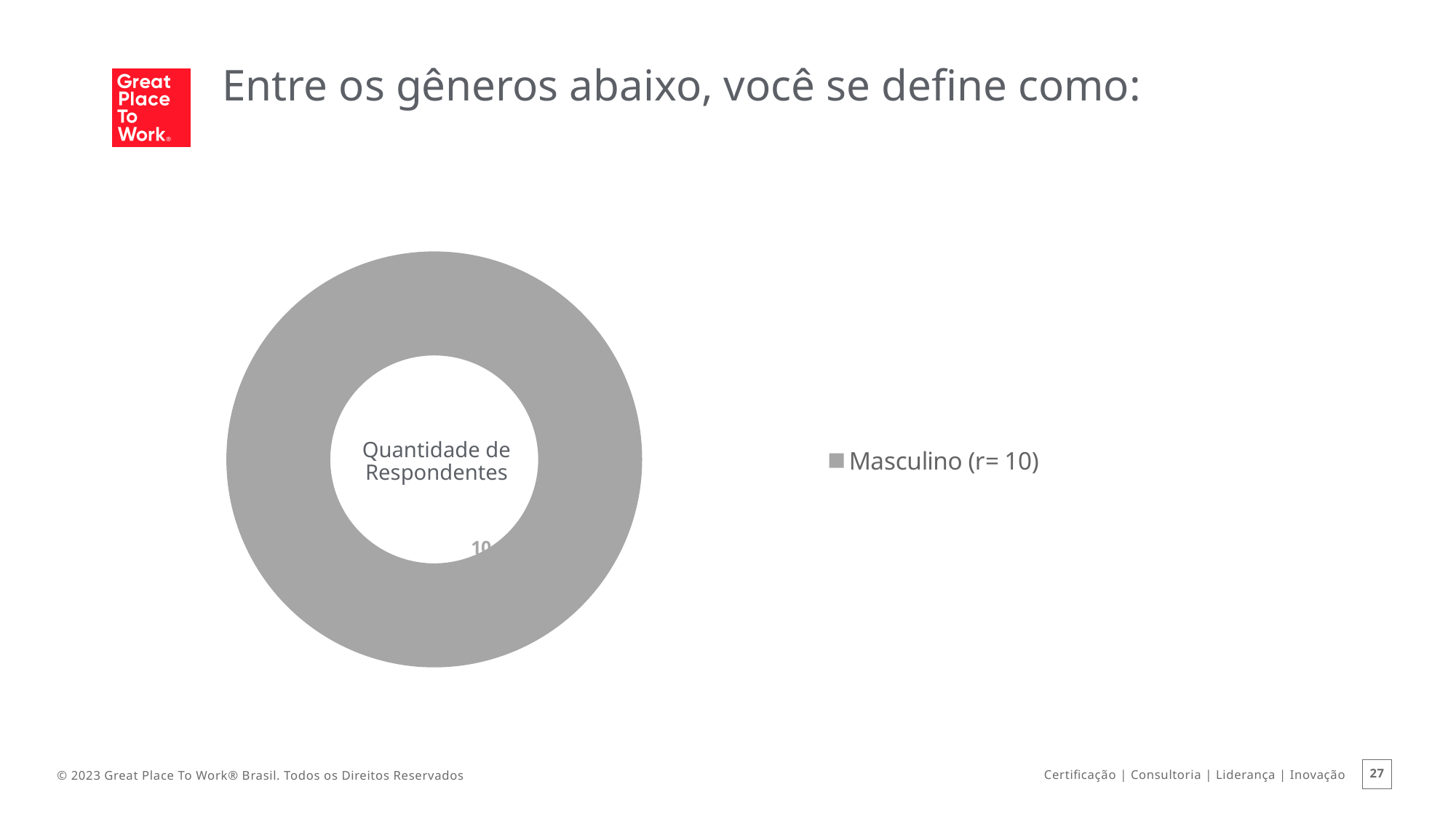
What kind of chart is shown on the slide? doughnut chart How many entries does the legend list? 1 What is the legend entry shown next to the chart? Masculino (r= 10) What share of the chart does the Masculino slice represent? 100% Which category is the largest in the chart? Masculino How many categories does the chart show? 1 What is the value shown for Masculino? 10 What text appears in the centre of the doughnut chart? Quantidade de Respondentes